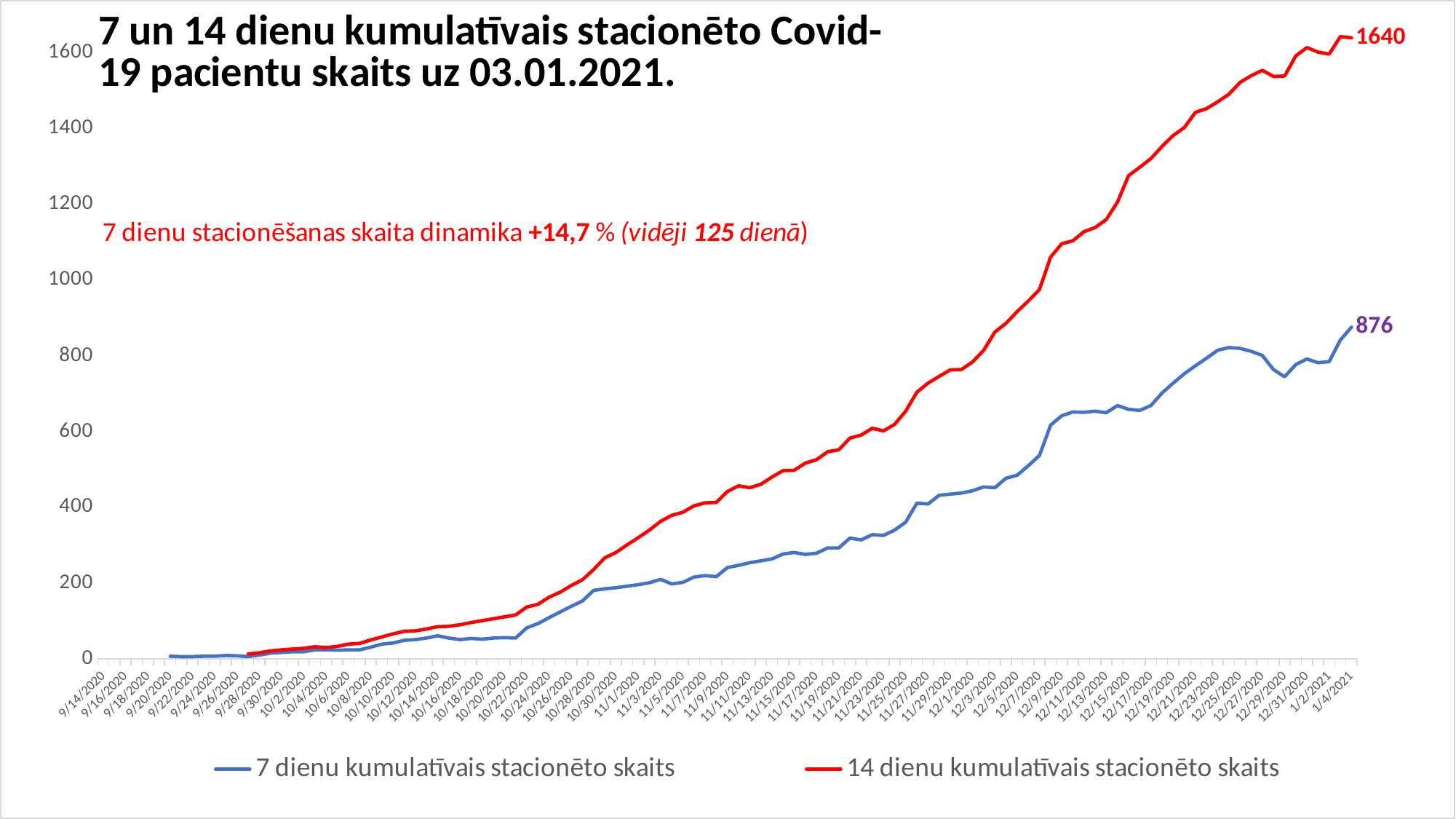
Does the 14 dienu kumulatīvais stacionēto skaits series generally rise or fall over the period shown? rise What is the difference between the final labelled values of the 14-day series (1640) and the 7-day series (876)? 764 What is the final labelled value of the 7 dienu kumulatīvais stacionēto skaits series? 876 What percentage is given for the 7 dienu stacionēšanas skaita dinamika in the annotation on the chart? +14,7 % Is the value of the 14 dienu series on 12/9/2020 greater or less than 1000? greater What colour is the line for the 7 dienu kumulatīvais stacionēto skaits series? blue Is the value of the 7 dienu series on 12/25/2020 greater or less than 600? greater Is the value of the 7 dienu series on 11/1/2020 greater or less than 400? less What is the final labelled value of the 14 dienu kumulatīvais stacionēto skaits series? 1640 How many series does the legend list? 2 What type of chart is shown on the slide? line chart Which series ends at a higher value, the 7 dienu or the 14 dienu kumulatīvais stacionēto skaits? 14 dienu kumulatīvais stacionēto skaits